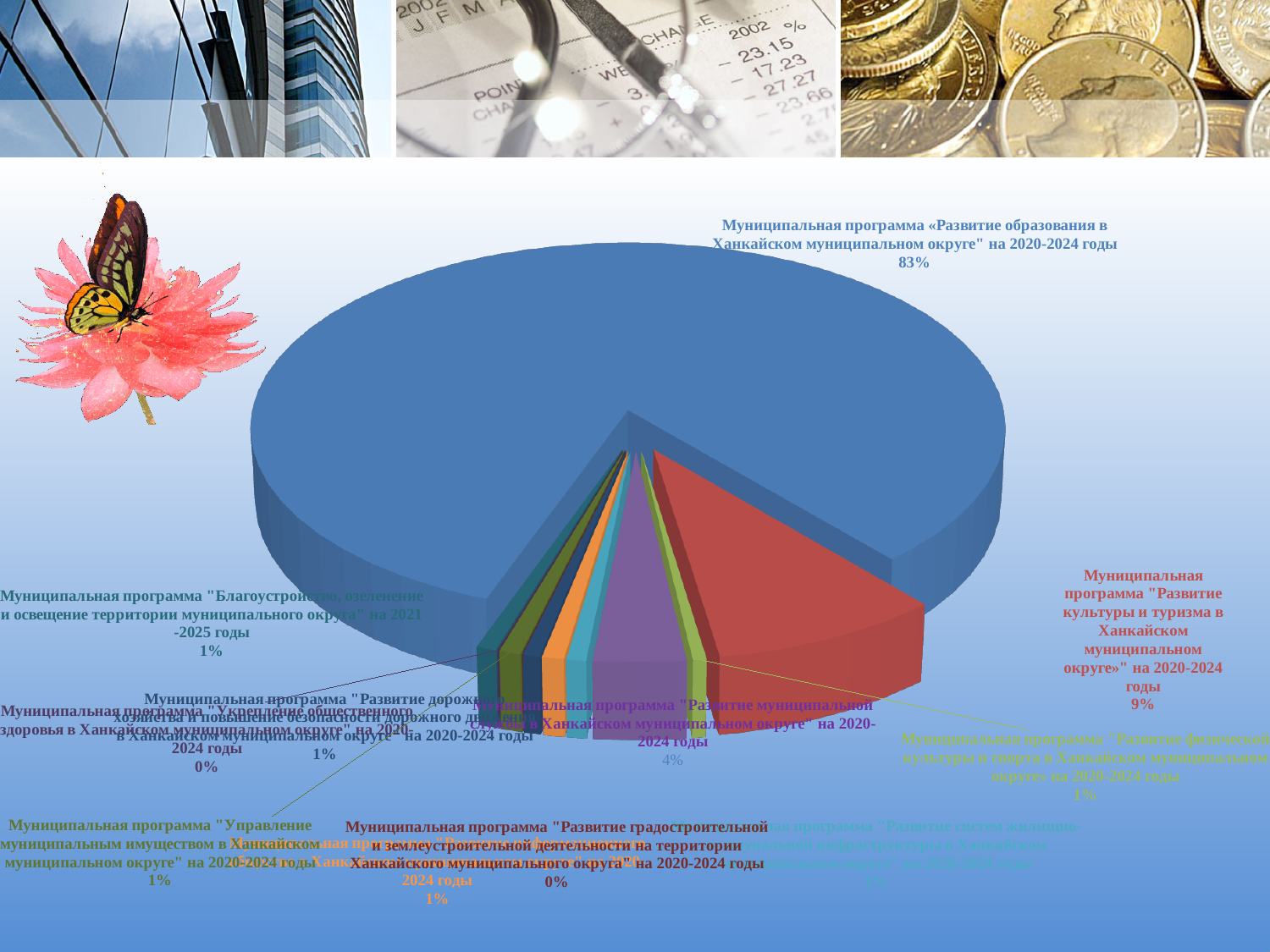
What percentage is shown for the programme «Управление муниципальным имуществом в Ханкайском муниципальном округе» на 2020-2024 годы? 1% What percentage is shown for the programme «Укрепление общественного здоровья в Ханкайском муниципальном округе» на 2020-2024 годы? 0% By how many percentage points does the education programme's share exceed the culture and tourism programme's share? 74 percentage points What percentage is shown for the programme «Развитие градостроительной и землеустроительной деятельности на территории Ханкайского муниципального округа» на 2020-2024 годы? 0% What colour is the slice for the education programme (83%)? Blue What percentage is shown for the programme «Развитие муниципальной службы в Ханкайском муниципальном округе» на 2020-2024 годы? 4% What percentage is shown for the programme «Развитие культуры и туризма в Ханкайском муниципальном округе» на 2020-2024 годы? 9% Which has the larger share: the culture and tourism programme or the municipal service programme? The culture and tourism programme What share of the pie does the programme «Развитие образования в Ханкайском муниципальном округе» на 2020-2024 годы have? 83% What kind of chart is shown on the slide? Pie chart Which programme has the largest share of the pie? Муниципальная программа «Развитие образования в Ханкайском муниципальном округе» на 2020-2024 годы What percentage is shown for the programme «Благоустройство, озеленение и освещение территории муниципального округа» на 2021-2025 годы? 1%